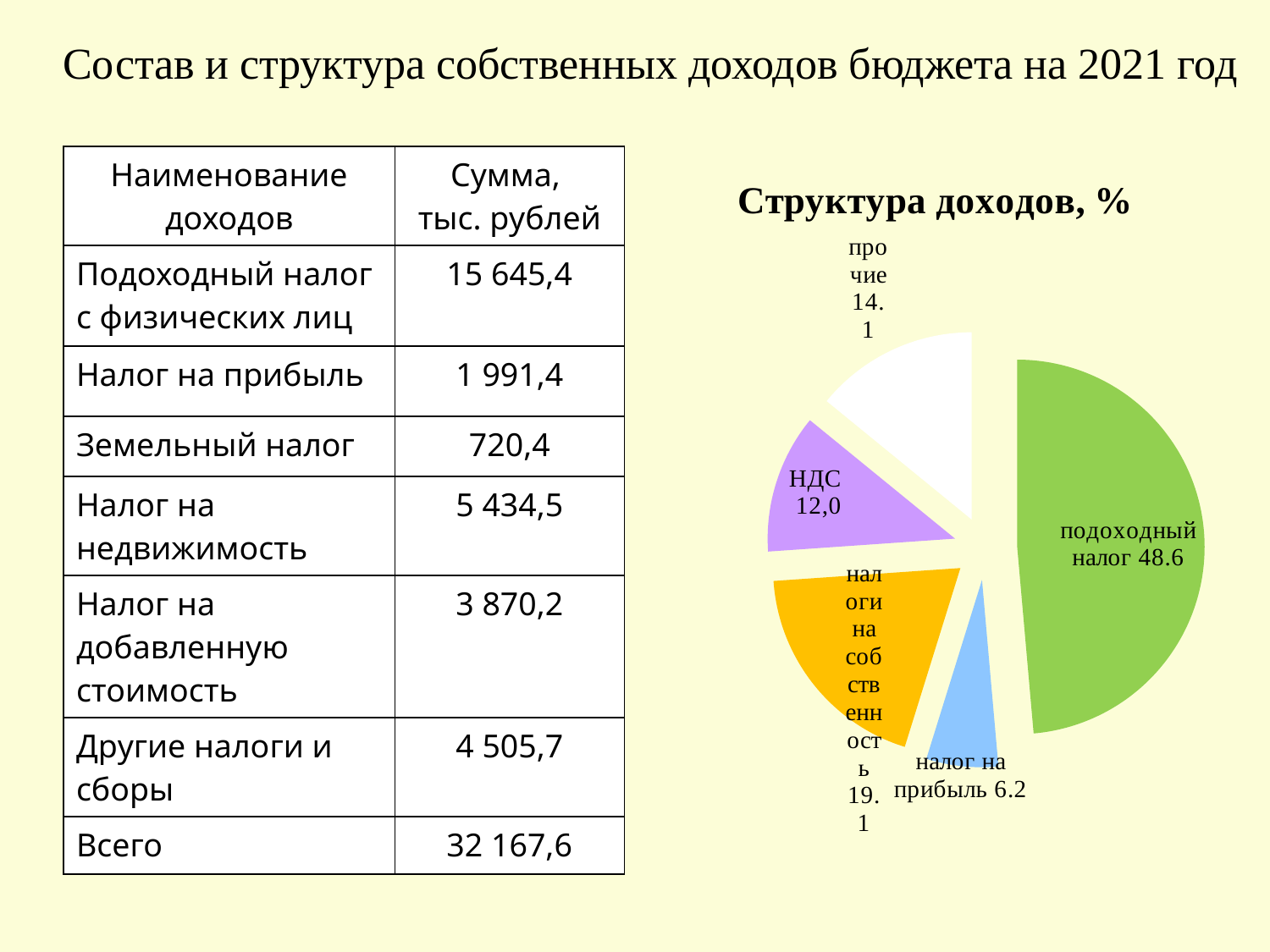
Which is larger in the pie chart, прочие or НДС? прочие What is the value shown for подоходный налог in the pie chart? 48.6 What is the title of the chart? Структура доходов, % What is the value shown for налоги на собственность in the pie chart? 19.1 What is the difference between the values for подоходный налог and НДС in the pie chart? 36.6 What kind of chart is shown on the slide? pie chart Which slice of the pie chart is the smallest? налог на прибыль What is the value shown for налог на прибыль in the pie chart? 6.2 What is the value shown for прочие in the pie chart? 14.1 What is the value shown for НДС in the pie chart? 12,0 How many slices does the pie chart have? 5 Which slice of the pie chart is the largest? подоходный налог